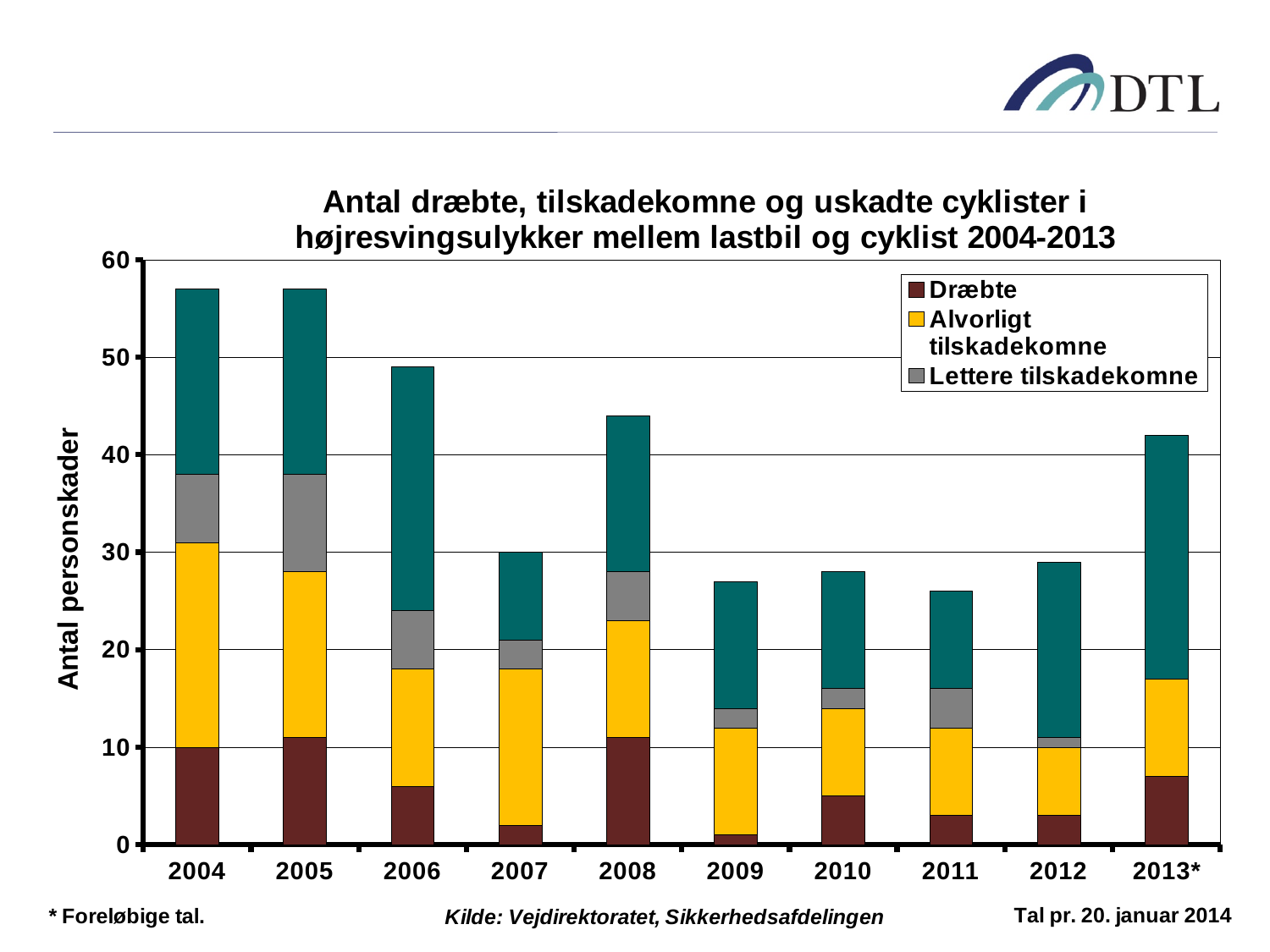
Is the total bar height for 2013* greater or less than 40? greater Which year has the smallest Dræbte segment? 2009 What kind of chart is shown on the slide? Stacked bar chart Is the total bar height for 2007 greater or less than 40? less Which year has a taller total bar, 2008 or 2007? 2008 How many series does the legend list? 3 Do the total bar heights generally rise or fall from 2004 to 2011? fall Is the total bar height for 2009 greater or less than 30? less What is the label on the y axis? Antal personskader Which year has a taller total bar, 2006 or 2013*? 2006 How many years (categories) are shown on the x axis? 10